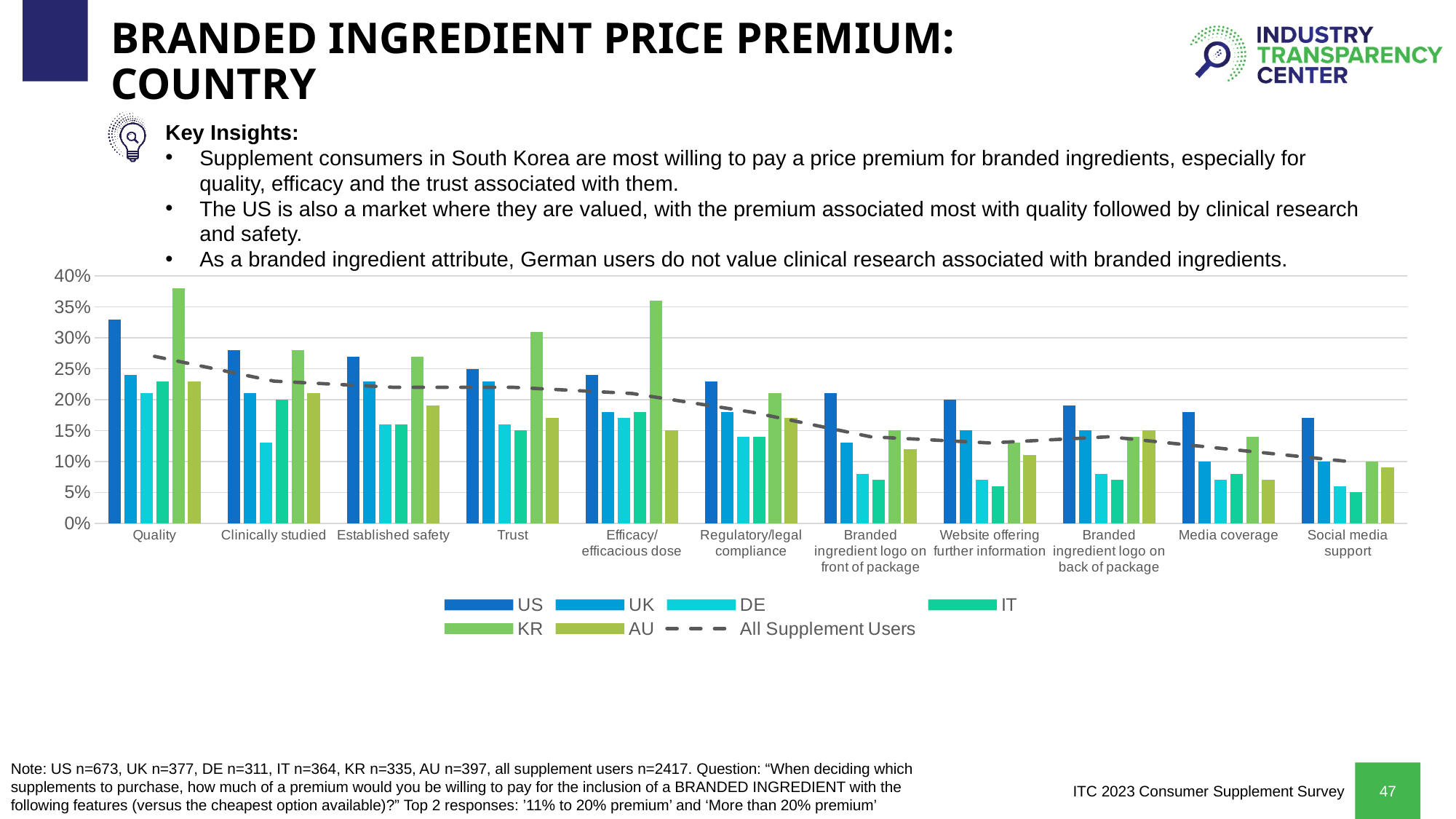
Is the IT value for Social media support greater or less than 10%? less Is the US value for Quality greater or less than 30%? greater Is the KR value for Quality greater or less than 35%? greater Which is larger for Media coverage, the US bar or the KR bar? US Which is larger for Clinically studied, the DE bar or the AU bar? AU Does the dashed All Supplement Users line generally rise or fall from left to right across the categories? Fall For which category is the KR bar the lowest? Social media support Which country has the tallest bar for Quality? KR How many series does the chart's legend list? 7 What kind of chart is shown on the slide? A bar chart with a dashed line series How many categories are shown along the x axis of the chart? 11 For which category is the US bar the highest? Quality